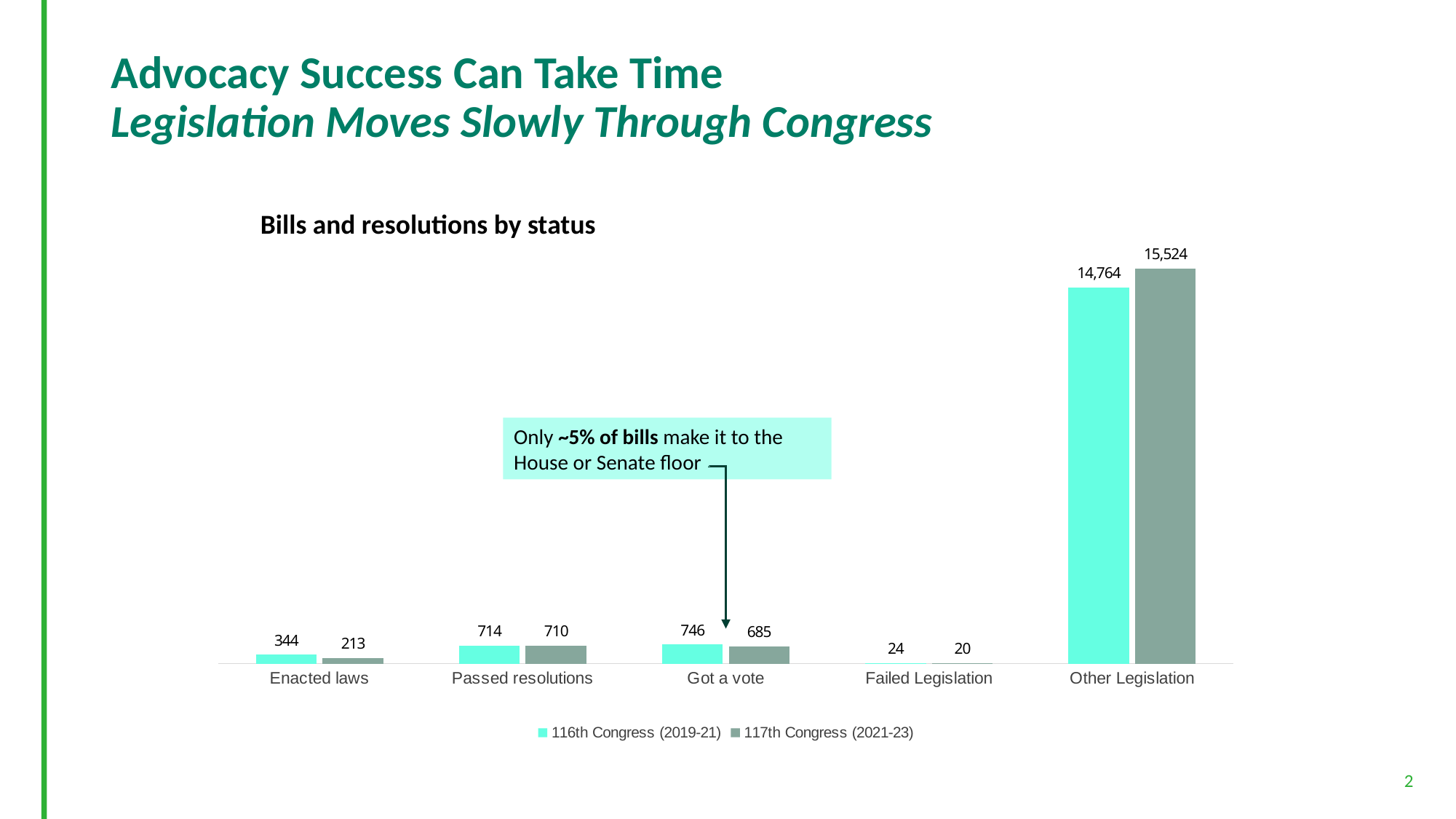
Which category has the lowest value for the 117th Congress (2021-23)? Failed Legislation What kind of chart is shown on the slide? Bar chart Which category has the highest value for the 116th Congress (2019-21)? Other Legislation Which is larger for Got a vote: the 116th Congress (2019-21) or the 117th Congress (2021-23)? 116th Congress (2019-21) What is the value for Enacted laws in the 116th Congress (2019-21)? 344 What is the difference between the 116th Congress and 117th Congress values for Enacted laws? 131 What is the difference between the 117th Congress and 116th Congress values for Other Legislation? 760 What is the title of the chart? Bills and resolutions by status How many categories are shown on the x axis? 5 What is the value for Failed Legislation in the 117th Congress (2021-23)? 20 How many series does the legend list? 2 What is the value for Other Legislation in the 117th Congress (2021-23)? 15,524